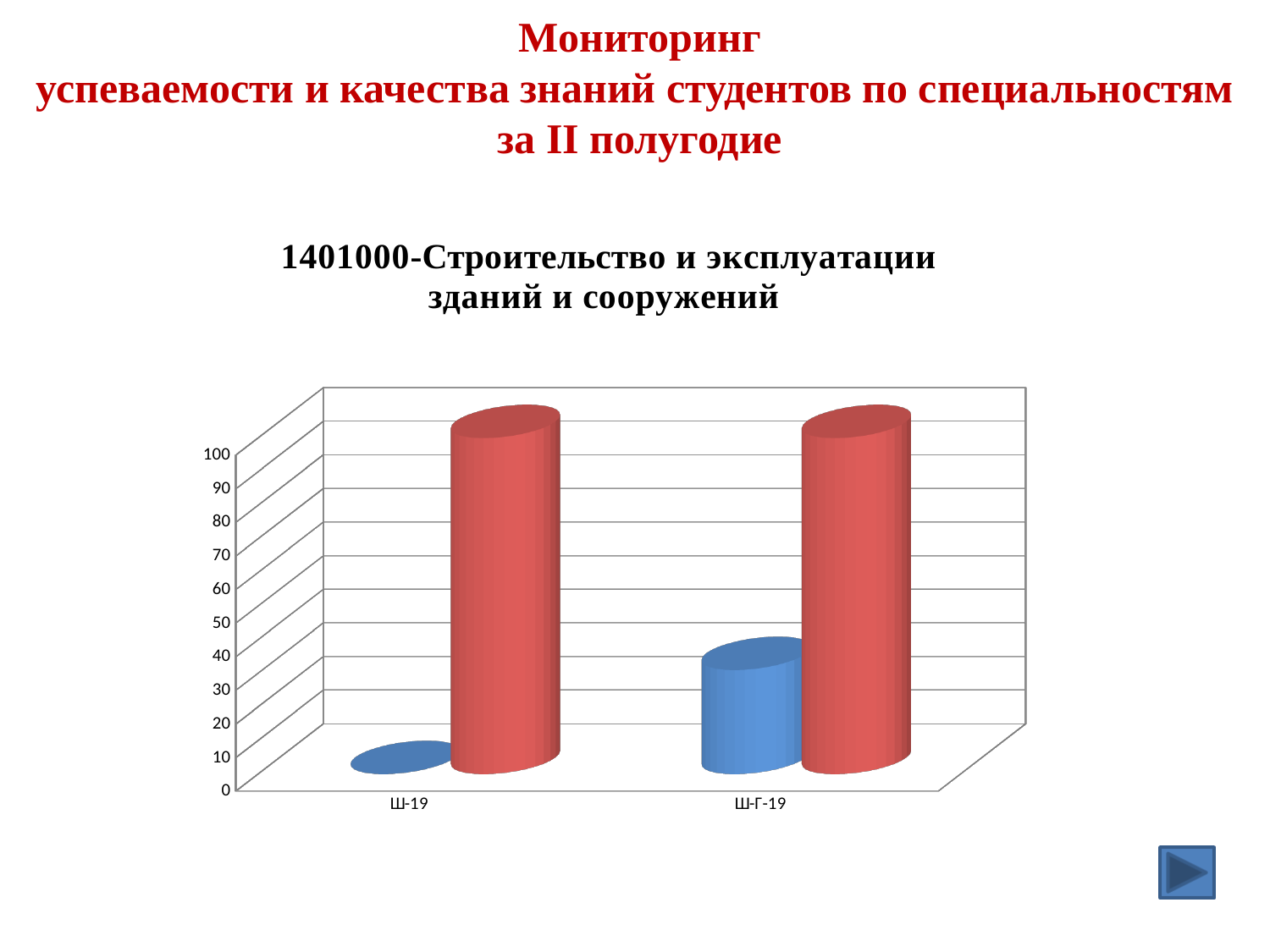
Is the value of the blue bar for Ш-Г-19 greater or less than 10? greater How many categories are shown on the x axis of the chart? 2 For Ш-19, which bar is larger, the blue one or the red one? the red one Is the value of the blue bar for Ш-19 greater or less than 20? less What kind of chart is shown on the slide? bar chart Is the value of the red bar for Ш-19 greater or less than 80? greater Which category has the lowest blue bar? Ш-19 What is the title of the chart? 1401000-Строительство и эксплуатации зданий и сооружений What is the highest value shown on the vertical axis? 100 What two colours are used for the bars in the chart? blue and red Which category has the higher blue bar, Ш-19 or Ш-Г-19? Ш-Г-19